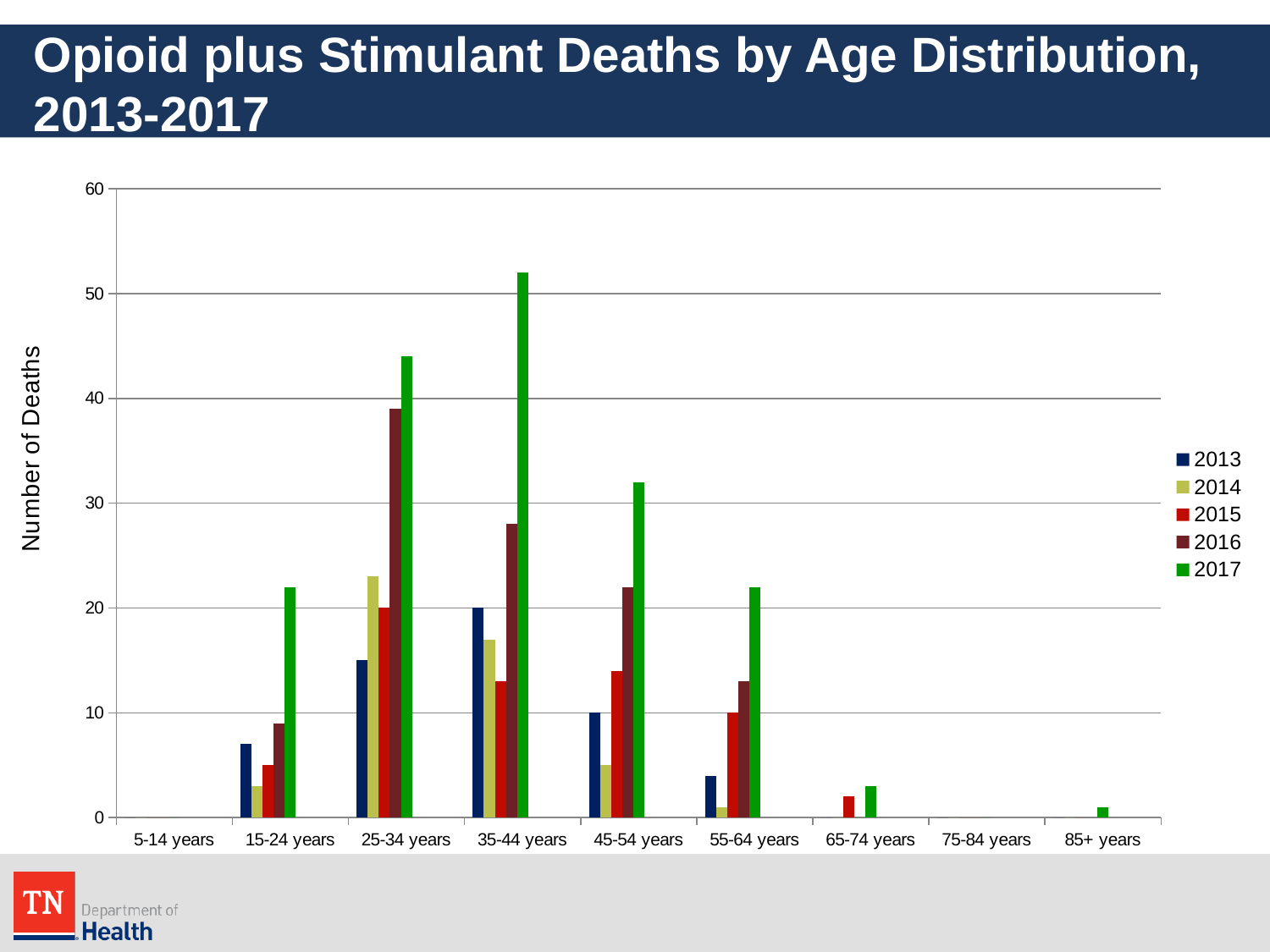
Which age group has the highest number of deaths for 2017? 35-44 years Is the 2017 value for 55-64 years greater or less than 30? less Which year has the highest number of deaths for the 15-24 years age group? 2017 Which is larger for 25-34 years, the 2013 value or the 2014 value? 2014 Do the 2017 values rise or fall across the age groups from 35-44 years to 85+ years? fall Is the 2016 value for 25-34 years greater or less than 30? greater How many series does the legend list? 5 Is the 2017 value for 35-44 years greater or less than 50? greater What is the label of the vertical axis? Number of Deaths How many age groups are shown on the x axis? 9 What type of chart is shown on the slide? Bar chart Which is larger, the 2017 value for 25-34 years or the 2017 value for 45-54 years? 25-34 years